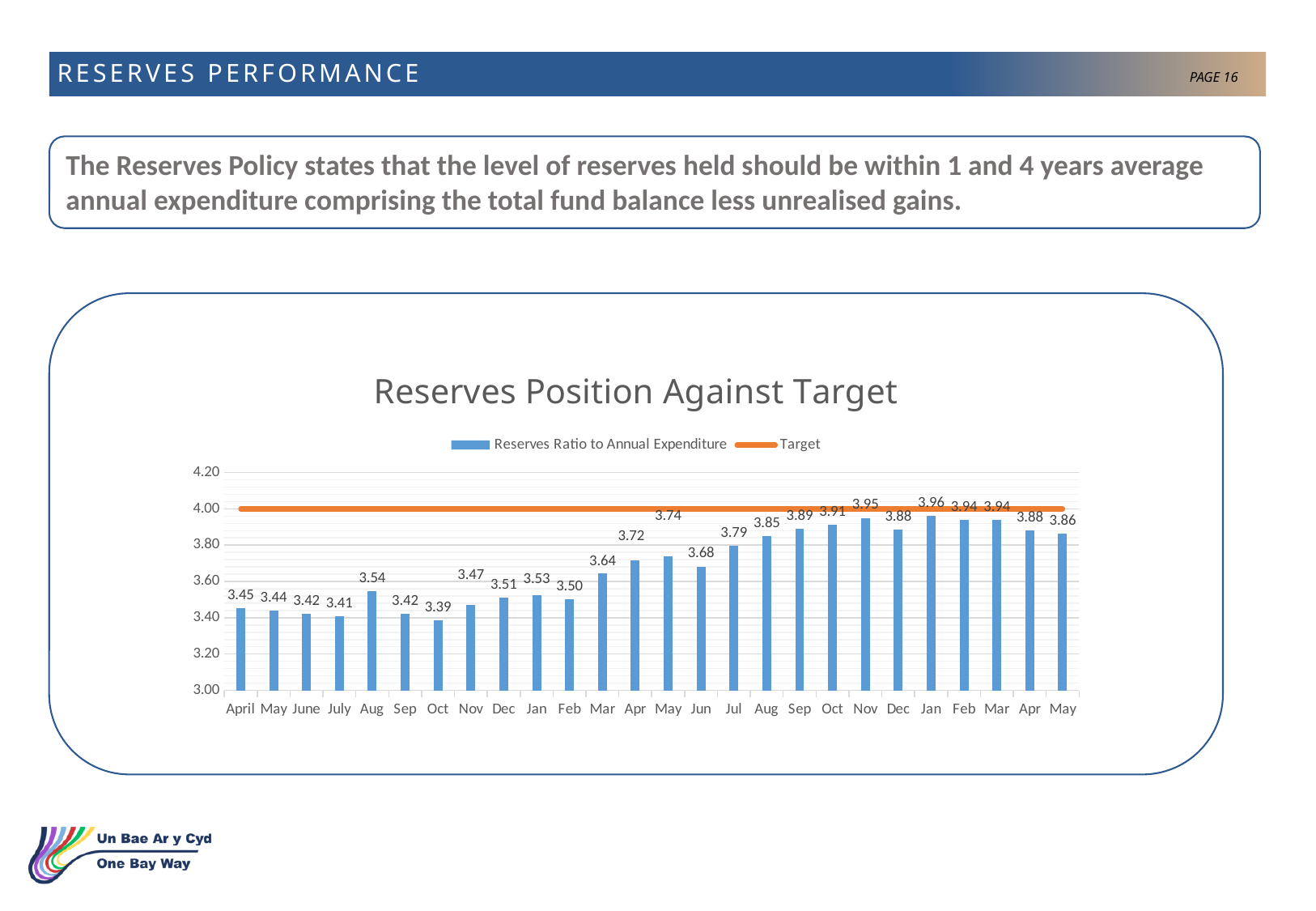
What type of chart is 'Reserves Position Against Target'? combination bar and line chart How many categories are shown on the x axis? 26 Overall, do the Reserves Ratio values rise or fall from April at the left to the second Jan? rise What is the lowest Reserves Ratio to Annual Expenditure value shown on the chart? 3.39 How many series does the legend list? 2 What is the highest Reserves Ratio to Annual Expenditure value shown on the chart? 3.96 What is the Reserves Ratio to Annual Expenditure for April, the first category on the x axis? 3.45 What is the difference between the Reserves Ratio for June (3.42) and the first Aug (3.54)? 0.12 Which has a higher Reserves Ratio to Annual Expenditure: April or July? April Is the Reserves Ratio for the second Jan (3.96) greater or less than 4.00? less What is the Reserves Ratio to Annual Expenditure for July? 3.41 What is the Reserves Ratio to Annual Expenditure for the last category, May, at the right end of the x axis? 3.86